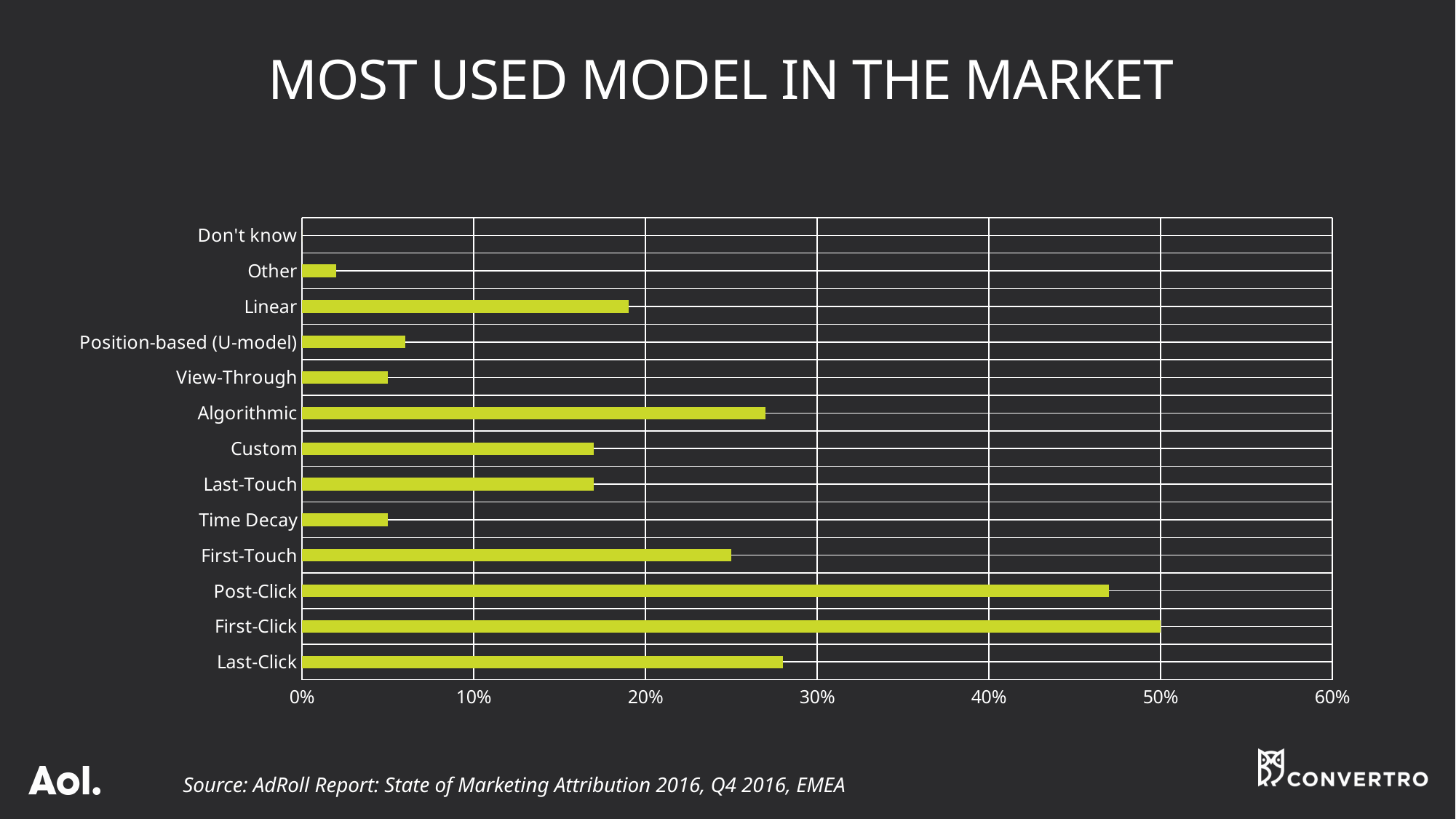
Is the value for Time Decay greater or less than 10%? less How many categories are listed on the chart? 13 Which category has the highest value? First-Click Is the value for Last-Click greater or less than 30%? less Which category has the lowest value? Don't know What kind of chart is shown on the slide? bar chart Is the value for Post-Click greater or less than 40%? greater Which is larger, the value for Algorithmic or the value for Linear? Algorithmic What is the title of the chart? MOST USED MODEL IN THE MARKET Which is larger, the value for Post-Click or the value for Last-Click? Post-Click